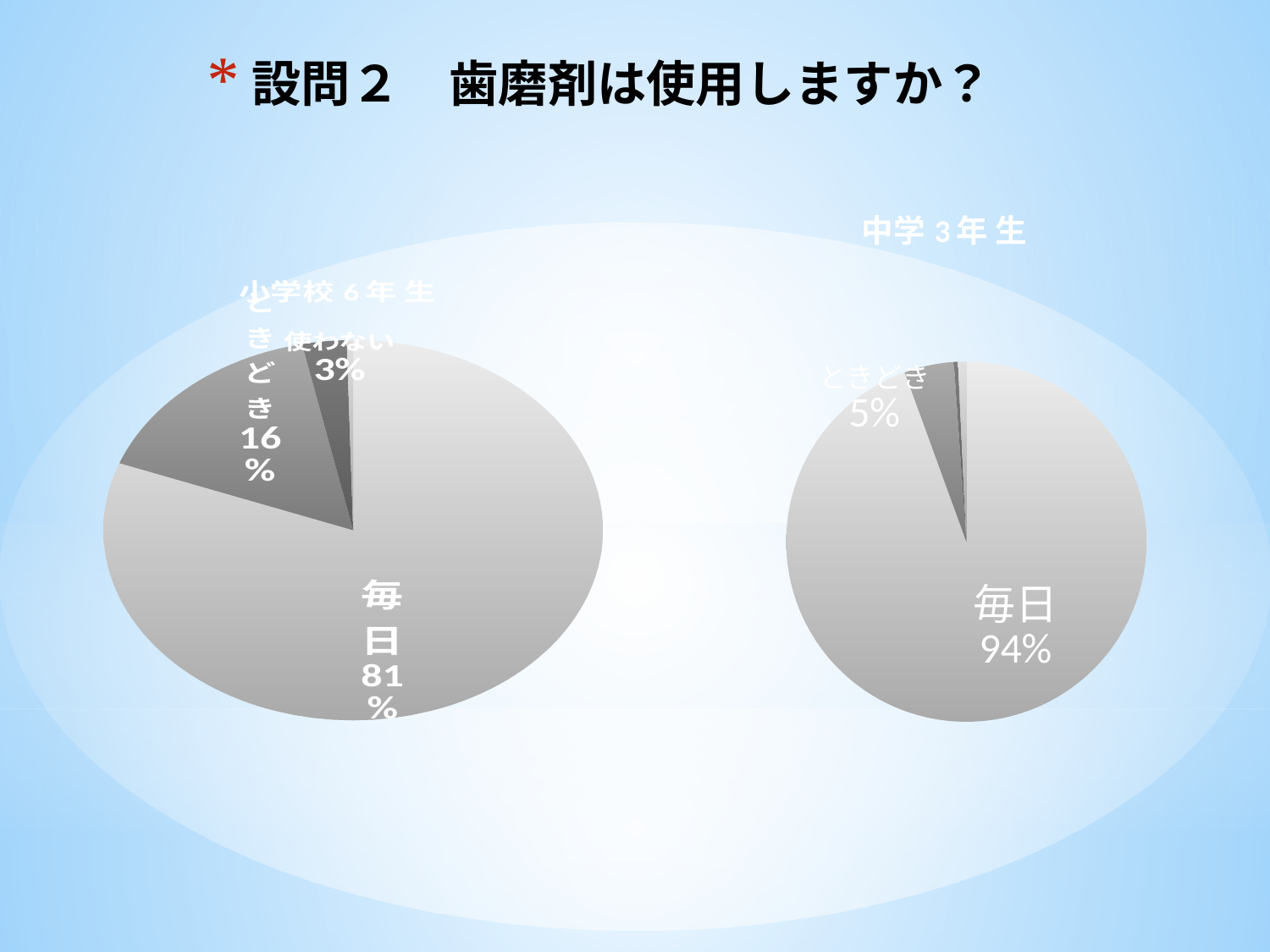
What is the title of the chart on the right side of the slide? 中学3年生 On the 中学3年生 pie chart, what share is labelled ときどき? 5% How many charts are shown on the slide? 2 Which is larger: the ときどき share on the 小学校6年生 chart or the ときどき share on the 中学3年生 chart? 小学校6年生 On the 小学校6年生 pie chart, what share is labelled ときどき? 16% On the 小学校6年生 pie chart, which category has the largest slice? 毎日 On the 中学3年生 pie chart, what share is labelled 毎日? 94% What is the difference between the 毎日 share on the 中学3年生 chart and the 毎日 share on the 小学校6年生 chart? 13% On the 小学校6年生 pie chart, what share is labelled 使わない? 3% On the 小学校6年生 pie chart, what share is labelled 毎日? 81% What kind of chart is used for the 小学校6年生 data? Pie chart